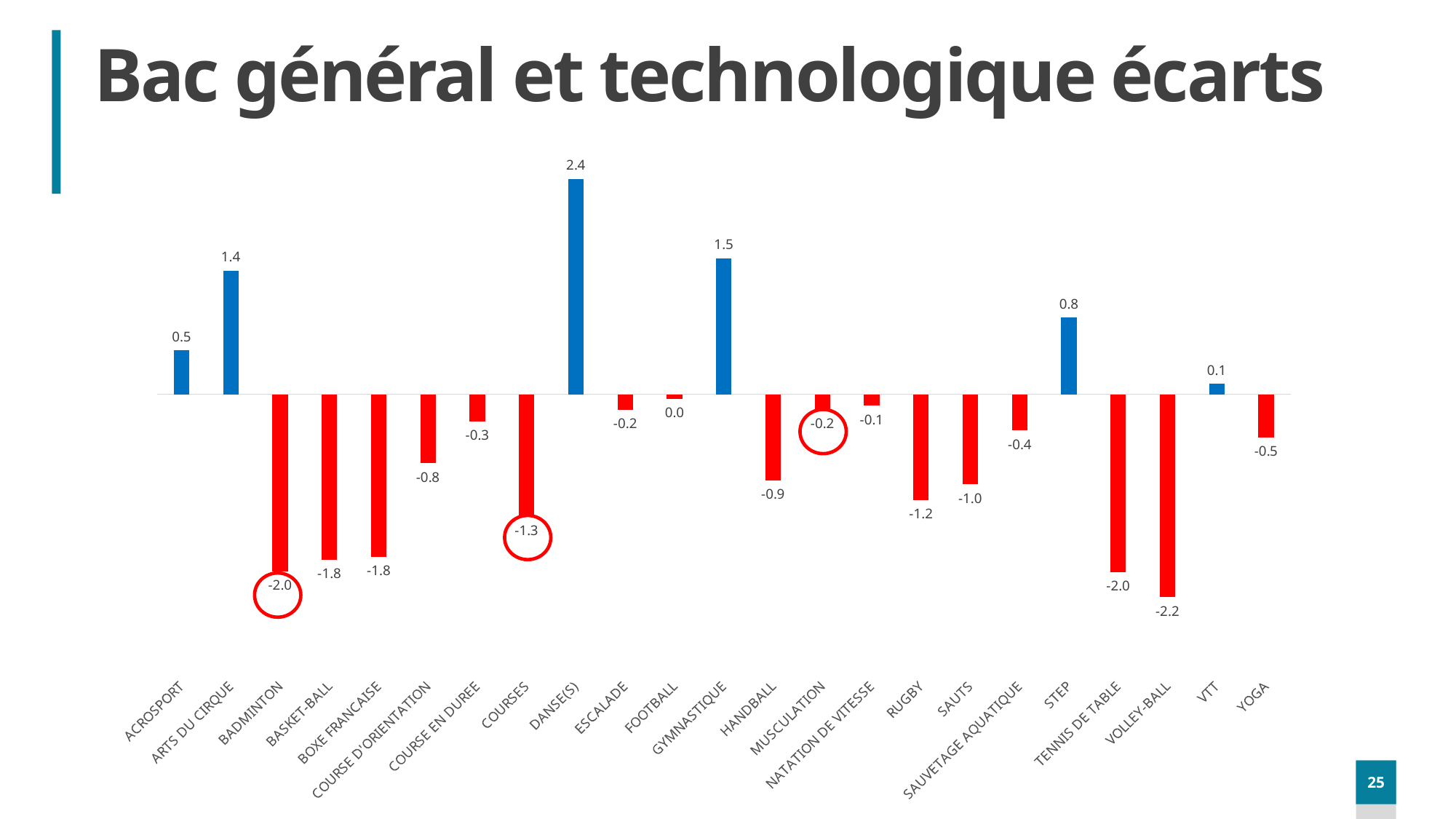
What colour are the bars with negative values? Red What is the value for COURSE D'ORIENTATION? -0.8 What kind of chart is shown on the slide? Bar chart What is the difference between the values for DANSE(S) and GYMNASTIQUE? 0.9 What is the value for STEP? 0.8 What is the value for VOLLEY-BALL? -2.2 What is the title of the slide? Bac général et technologique écarts Which category has the highest value? DANSE(S) What is the value for DANSE(S)? 2.4 How many categories are shown on the x axis? 23 Which category has the lowest value? VOLLEY-BALL Which is larger, the value for ARTS DU CIRQUE or the value for STEP? ARTS DU CIRQUE